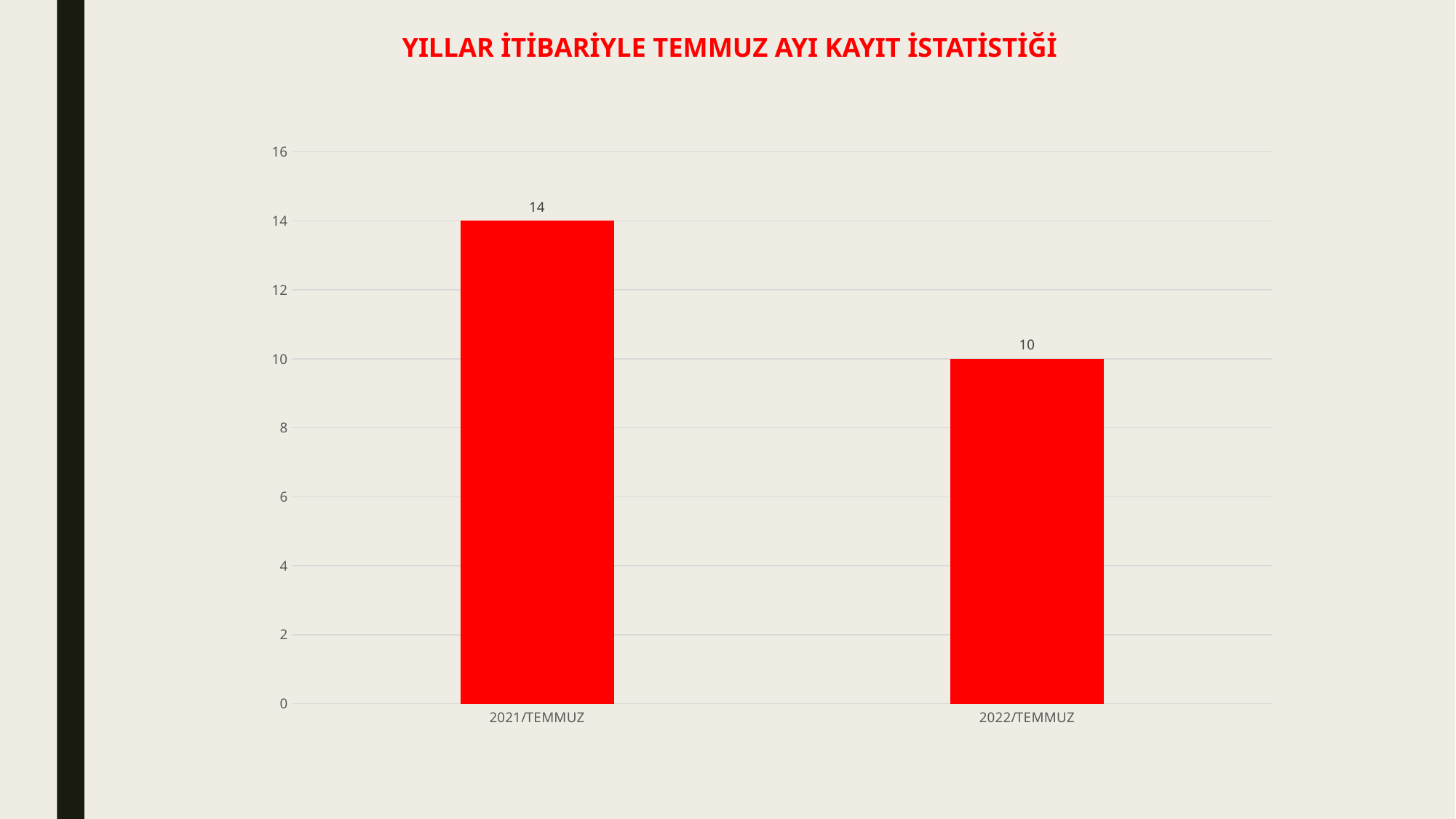
What kind of chart is shown on the slide? bar chart Which category has the lowest value? 2022/TEMMUZ What is the value for 2021/TEMMUZ? 14 Which category has the highest value? 2021/TEMMUZ How many categories are shown on the x axis? 2 Do the values rise or fall from 2021/TEMMUZ to 2022/TEMMUZ? fall What is the difference between the values for 2021/TEMMUZ and 2022/TEMMUZ? 4 Is the value for 2022/TEMMUZ greater or less than 12? less Which is larger, the value for 2021/TEMMUZ or the value for 2022/TEMMUZ? 2021/TEMMUZ What colour are the bars in the chart? red What is the value for 2022/TEMMUZ? 10 What is the title of the chart? YILLAR İTİBARİYLE TEMMUZ AYI KAYIT İSTATİSTİĞİ